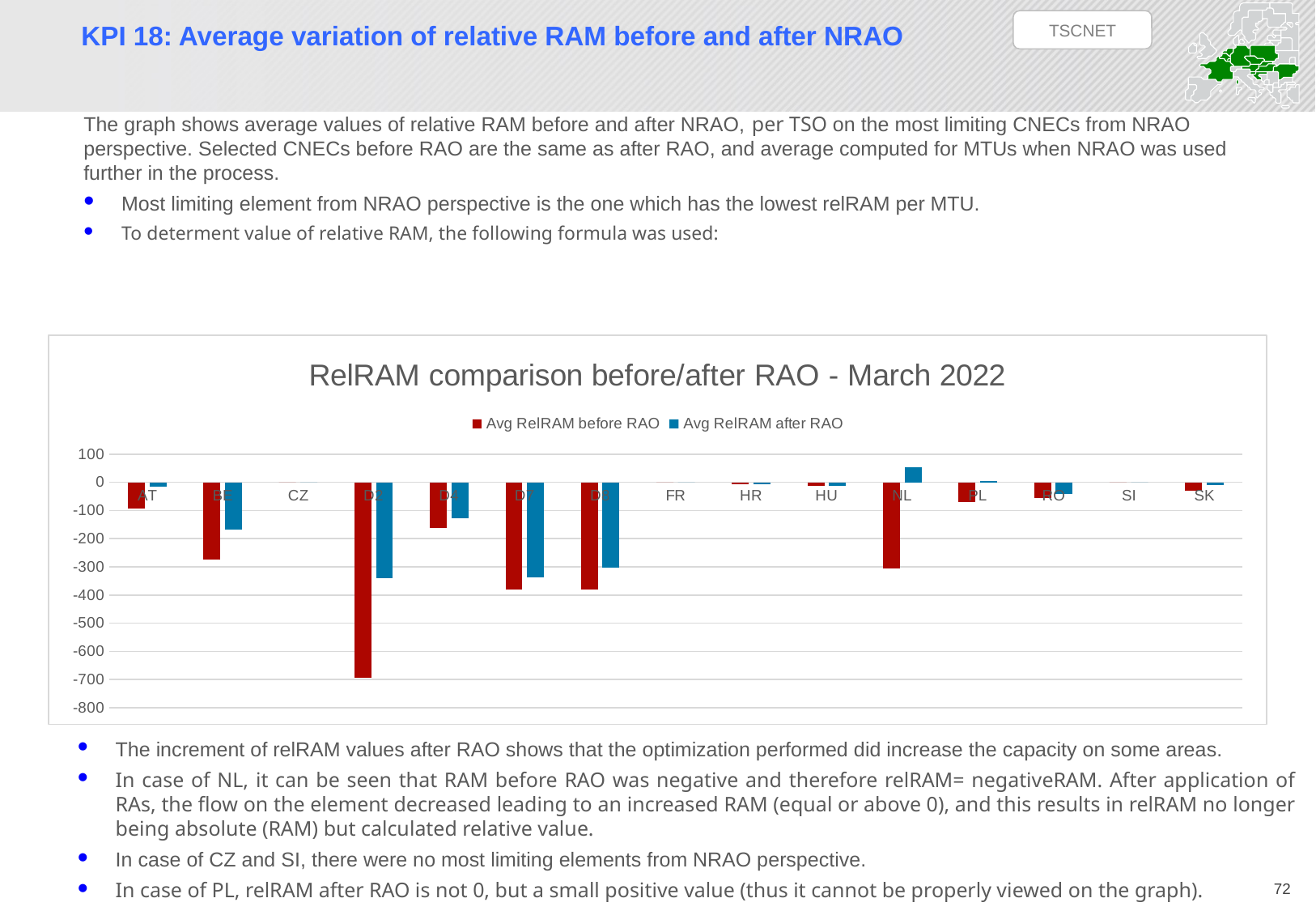
What is the title of the chart? RelRAM comparison before/after RAO - March 2022 What are the two series named in the chart legend? Avg RelRAM before RAO and Avg RelRAM after RAO How many series does the legend of the chart list? 2 Is the Avg RelRAM before RAO for NL greater or less than -200? less What kind of chart is shown on the slide? bar chart Is the Avg RelRAM before RAO for AT greater or less than -200? greater Is the Avg RelRAM after RAO for NL greater or less than 0? greater For BE, which is larger: Avg RelRAM before RAO or Avg RelRAM after RAO? Avg RelRAM after RAO Which category has the highest Avg RelRAM after RAO? NL How many categories are shown on the x axis of the chart? 15